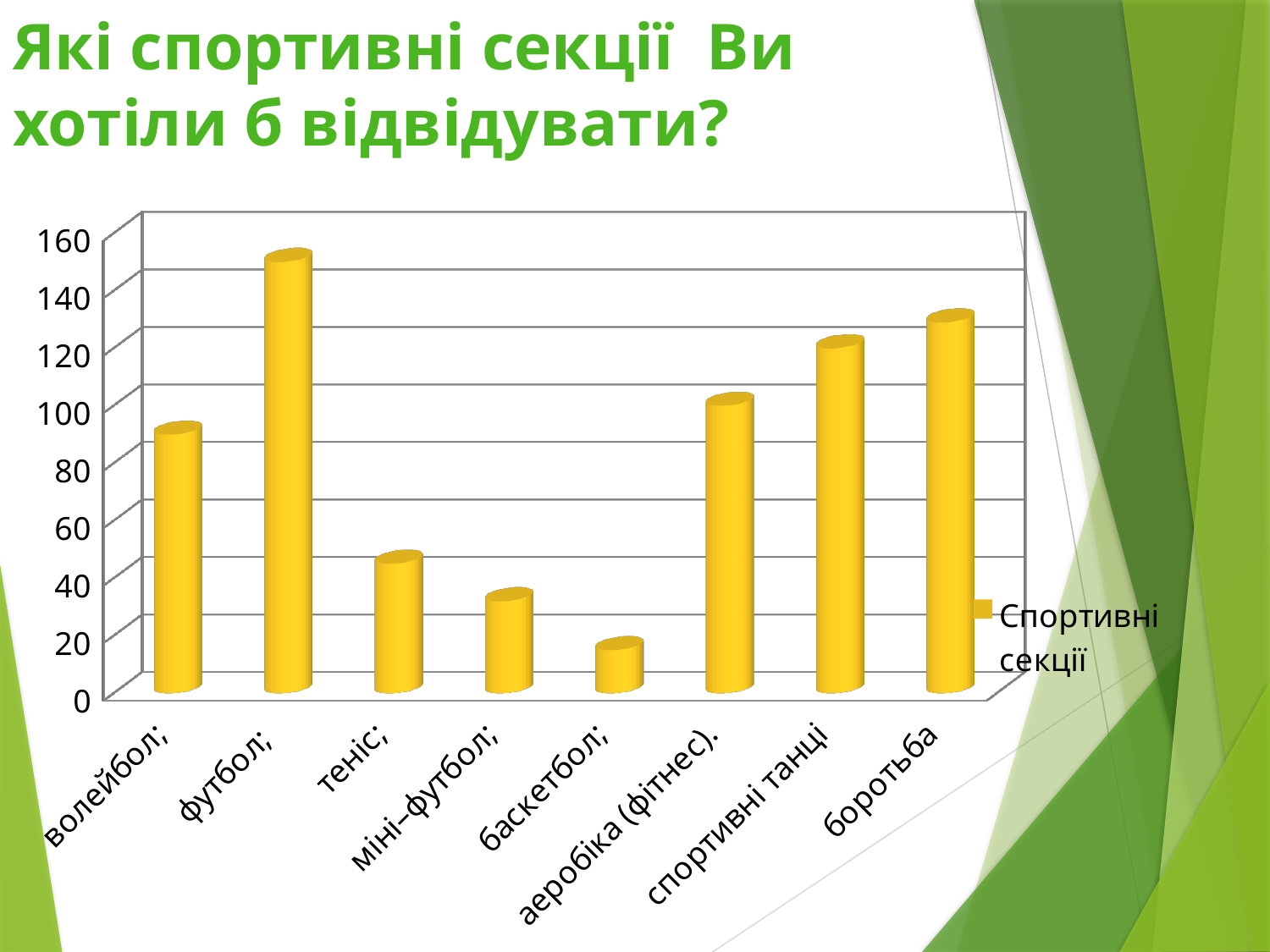
Which category has the lowest bar? баскетбол Is the value for спортивні танці greater or less than 100? greater What kind of chart is shown on the slide? bar chart Which category has the highest bar? футбол What is the legend entry shown on the chart? Спортивні секції How many categories are shown on the x axis of the chart? 8 Which is larger, the value for теніс or the value for міні-футбол? теніс Is the value for волейбол greater or less than 80? greater Is the value for баскетбол greater or less than 40? less How many series does the legend list? 1